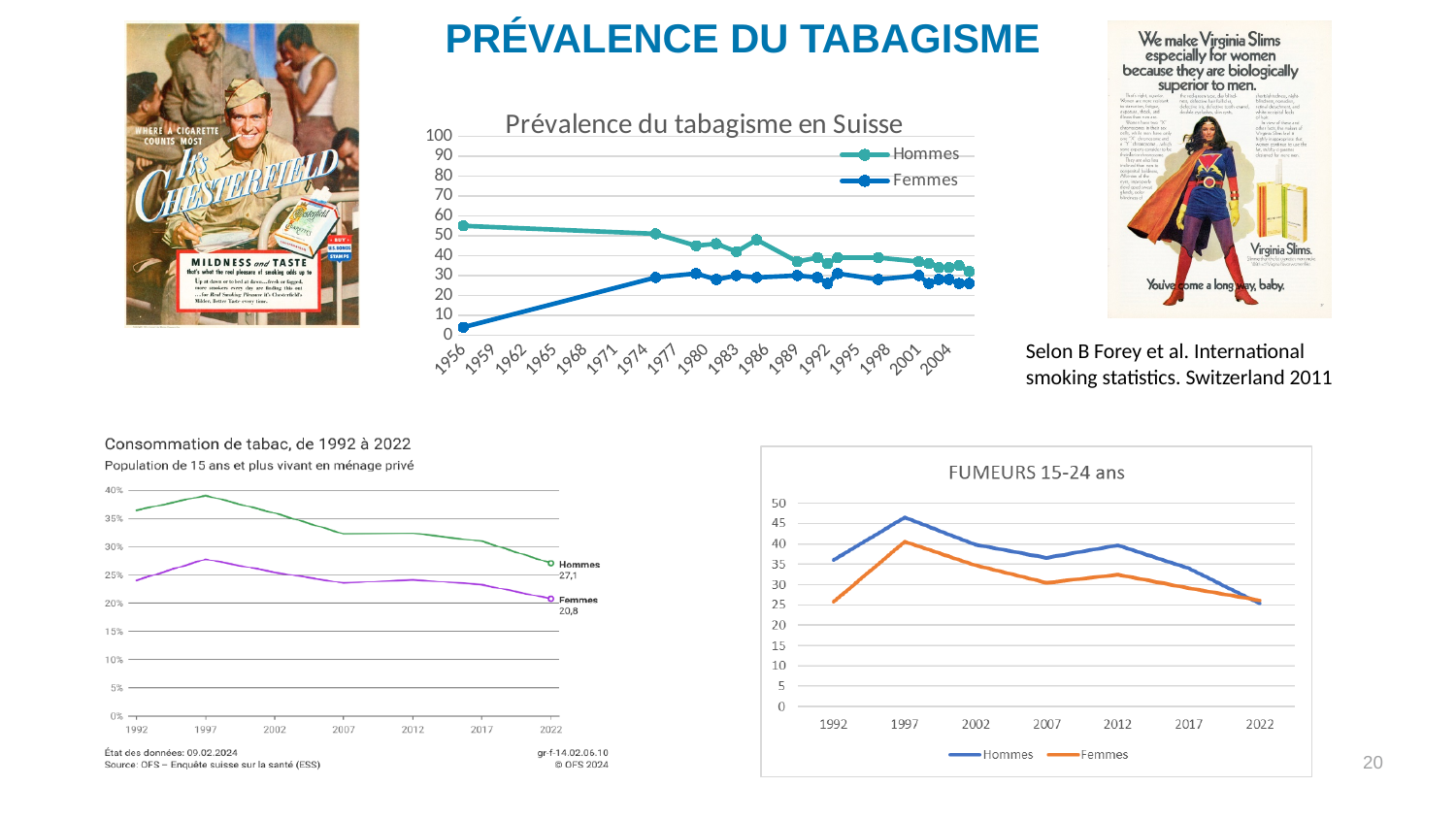
In the 'Prévalence du tabagisme en Suisse' chart, is the value for Hommes in 1956 greater or less than 50? greater In the 'Consommation de tabac, de 1992 à 2022' chart, is the value for Hommes in 1997 greater or less than 35%? greater In the 'Consommation de tabac, de 1992 à 2022' chart, what is the difference between the Hommes and Femmes values in 2022? 6,3 How many series does the legend of the 'Prévalence du tabagisme en Suisse' chart list? 2 In the 'Prévalence du tabagisme en Suisse' chart, does the Hommes series rise or fall from 1956 to 2004? fall In the 'Consommation de tabac, de 1992 à 2022' chart, what is the value for Hommes in 2022? 27,1 In the 'Prévalence du tabagisme en Suisse' chart, is the value for Femmes in 1956 greater or less than 10? less In the 'Consommation de tabac, de 1992 à 2022' chart, what is the value for Femmes in 2022? 20,8 How many years are shown on the x axis of the 'FUMEURS 15-24 ans' chart? 7 In the 'FUMEURS 15-24 ans' chart, in which year is the Hommes series highest? 1997 In the 'Prévalence du tabagisme en Suisse' chart, which series is higher in 1980, Hommes or Femmes? Hommes What type of chart is the 'Prévalence du tabagisme en Suisse' chart? line chart